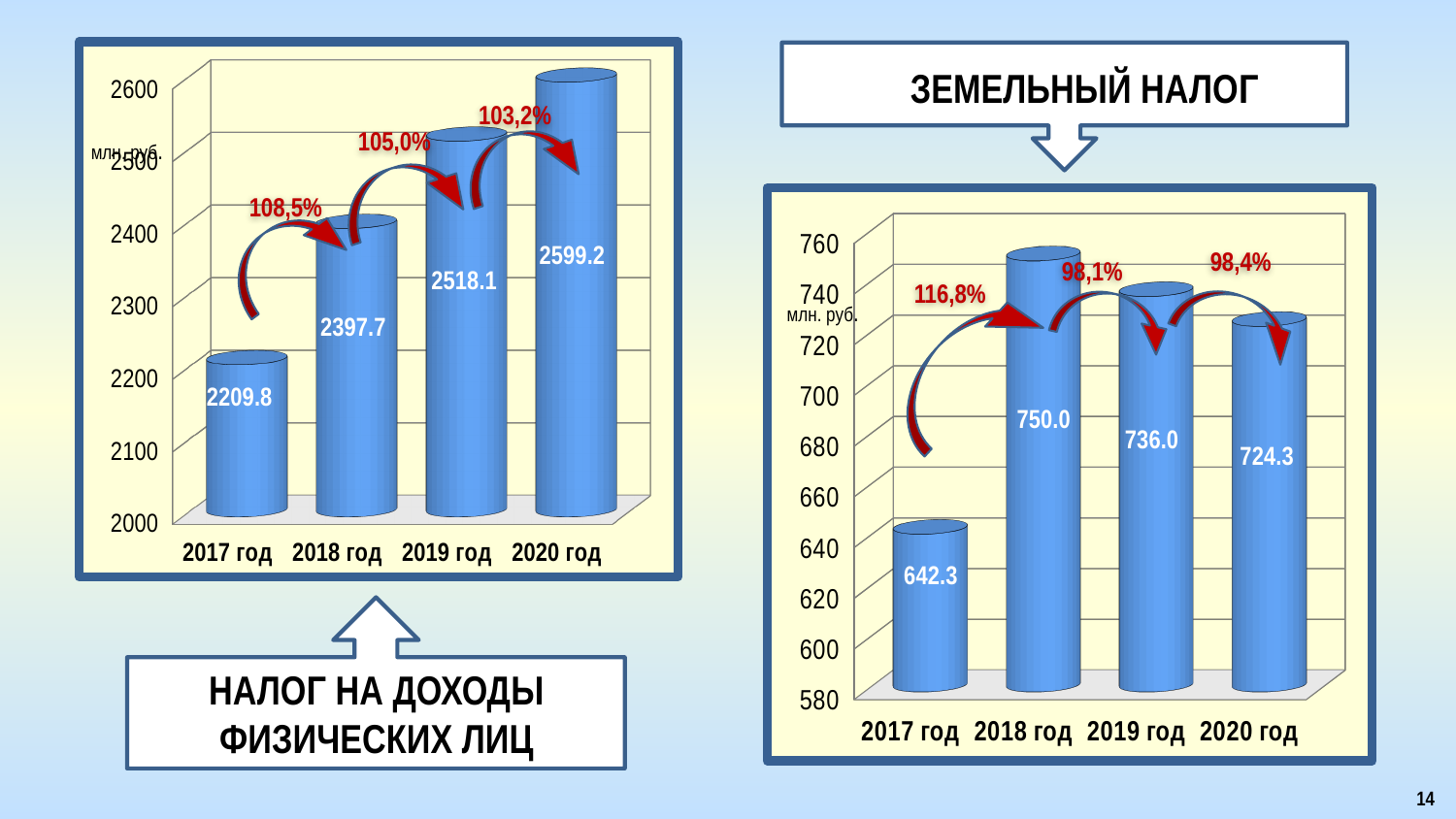
In the chart for ЗЕМЕЛЬНЫЙ НАЛОГ, which year has the highest value? 2018 год In the chart for ЗЕМЕЛЬНЫЙ НАЛОГ, what is the value for 2019 год? 736.0 In the chart for НАЛОГ НА ДОХОДЫ ФИЗИЧЕСКИХ ЛИЦ, do the values rise or fall from 2017 год to 2020 год? rise In the chart for ЗЕМЕЛЬНЫЙ НАЛОГ, what is the difference between the values for 2018 год and 2017 год? 107.7 In the chart for ЗЕМЕЛЬНЫЙ НАЛОГ, which is larger, the value for 2019 год or 2020 год? 2019 год In the chart for НАЛОГ НА ДОХОДЫ ФИЗИЧЕСКИХ ЛИЦ, what is the difference between the values for 2020 год and 2017 год? 389.4 How many years are shown in the chart for ЗЕМЕЛЬНЫЙ НАЛОГ? 4 In the chart for ЗЕМЕЛЬНЫЙ НАЛОГ, what is the value for 2017 год? 642.3 What kind of chart is used for НАЛОГ НА ДОХОДЫ ФИЗИЧЕСКИХ ЛИЦ? bar chart In the chart for НАЛОГ НА ДОХОДЫ ФИЗИЧЕСКИХ ЛИЦ, which year has the lowest value? 2017 год In the chart for НАЛОГ НА ДОХОДЫ ФИЗИЧЕСКИХ ЛИЦ, what is the value for 2020 год? 2599.2 In the chart for НАЛОГ НА ДОХОДЫ ФИЗИЧЕСКИХ ЛИЦ, what is the value for 2018 год? 2397.7